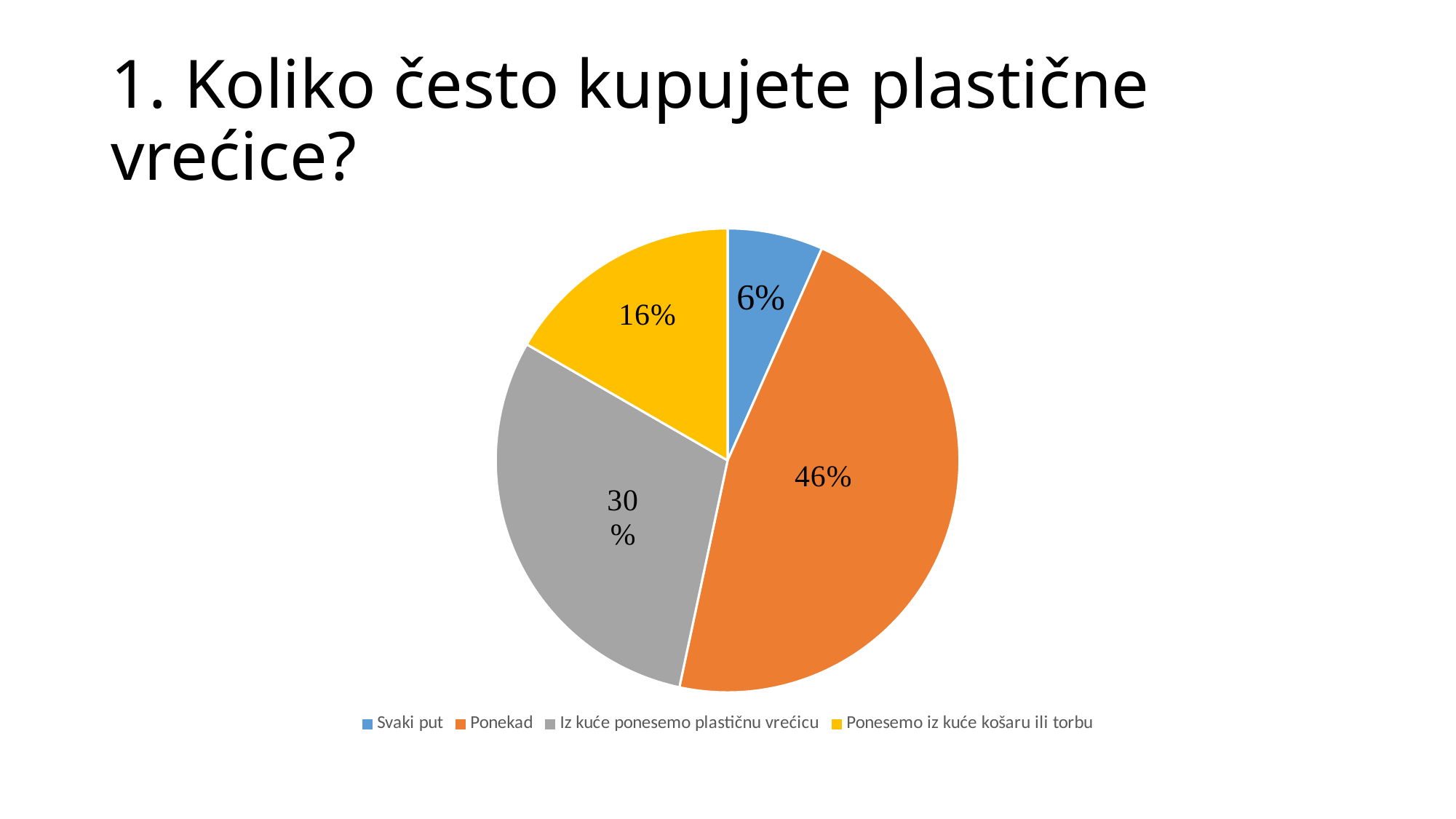
Which category has the smallest slice of the pie? Svaki put What is the title of the slide containing the chart? 1. Koliko često kupujete plastične vrećice? Which is larger, the share for "Ponesemo iz kuće košaru ili torbu" or the share for "Svaki put"? Ponesemo iz kuće košaru ili torbu What share of the pie does "Svaki put" have? 6% What share of the pie does "Iz kuće ponesemo plastičnu vrećicu" have? 30% What share of the pie does "Ponekad" have? 46% What is the difference between the shares of "Ponekad" and "Iz kuće ponesemo plastičnu vrećicu"? 16% What colour is the slice for "Ponekad"? orange How many categories does the pie chart have? 4 What kind of chart is shown on the slide? pie chart Which category has the largest slice of the pie? Ponekad